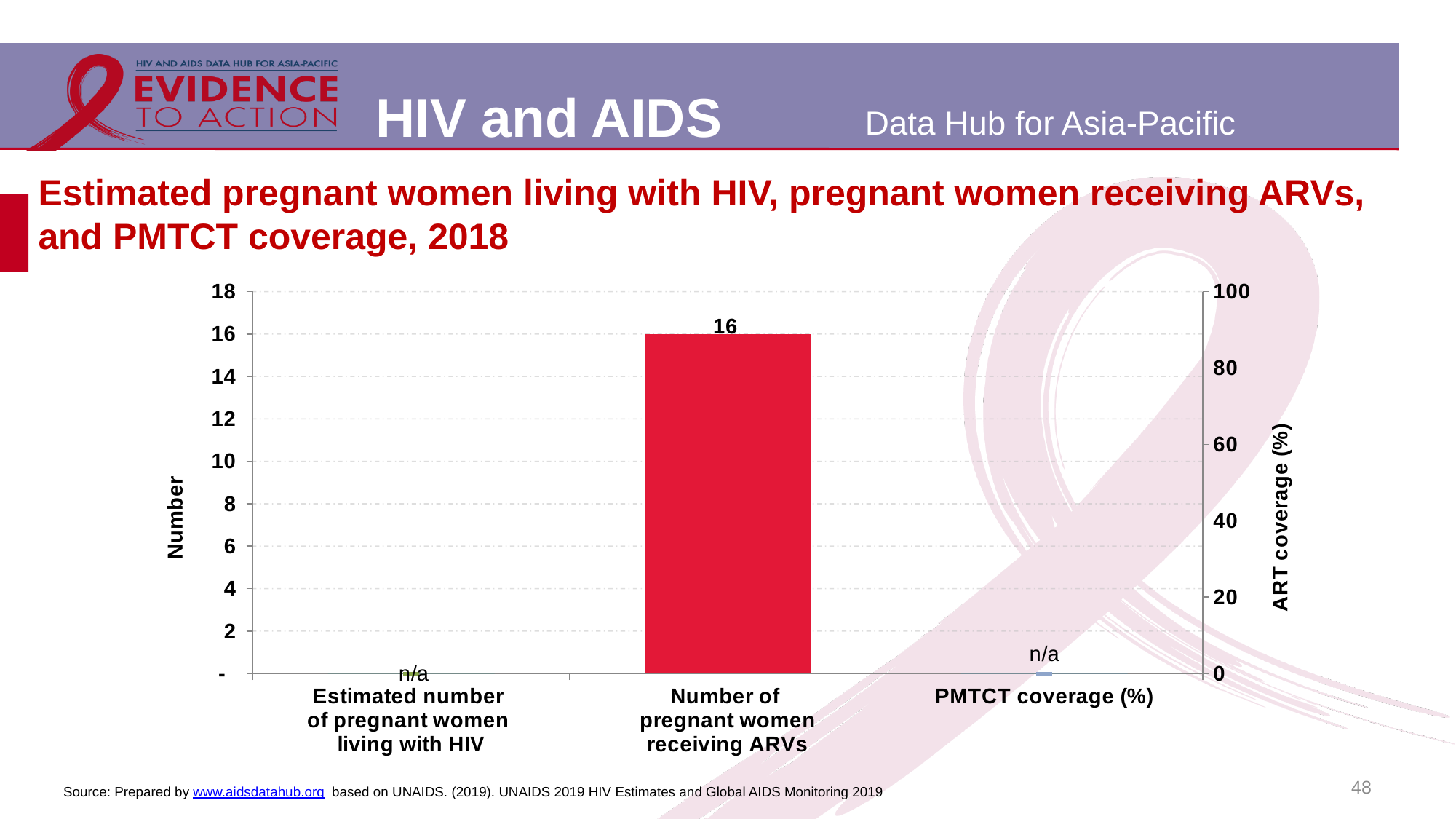
How many categories are shown on the x axis? 3 What kind of chart is this? bar chart What is the label of the left vertical axis? Number What is shown for Estimated number of pregnant women living with HIV? n/a Is the value for Number of pregnant women receiving ARVs greater or less than 10? greater How many categories are labelled n/a? 2 What is shown for PMTCT coverage (%)? n/a What is the value for Number of pregnant women receiving ARVs? 16 What is the maximum value shown on the left vertical axis? 18 What is the label of the right vertical axis? ART coverage (%) Is the value for Number of pregnant women receiving ARVs greater or less than 18? less Which category has the highest plotted value? Number of pregnant women receiving ARVs